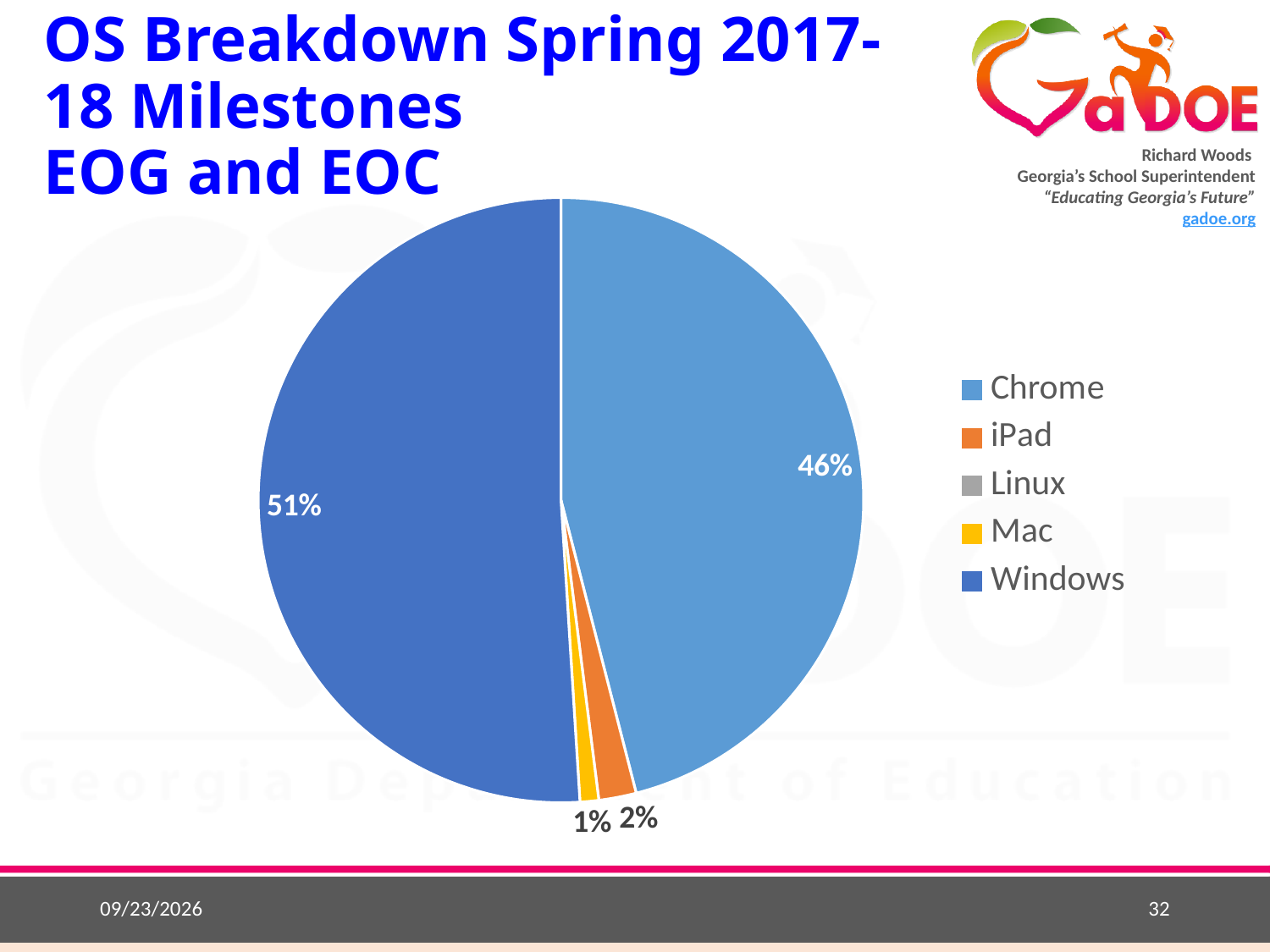
How many operating systems are listed in the legend? 5 Which operating system has the largest slice of the pie? Windows What is the title of the slide containing the chart? OS Breakdown Spring 2017-18 Milestones EOG and EOC Which is larger, the Windows slice or the Chrome slice? Windows What percentage of the pie does iPad account for? 2% What is the difference in percentage points between the Windows slice and the Chrome slice? 5 percentage points What percentage of the pie does Chrome account for? 46% What percentage of the pie does Mac account for? 1% What kind of chart is shown on the slide? pie chart What colour represents Mac in the legend? yellow Which is larger, the iPad slice or the Mac slice? iPad What percentage of the pie does Windows account for? 51%